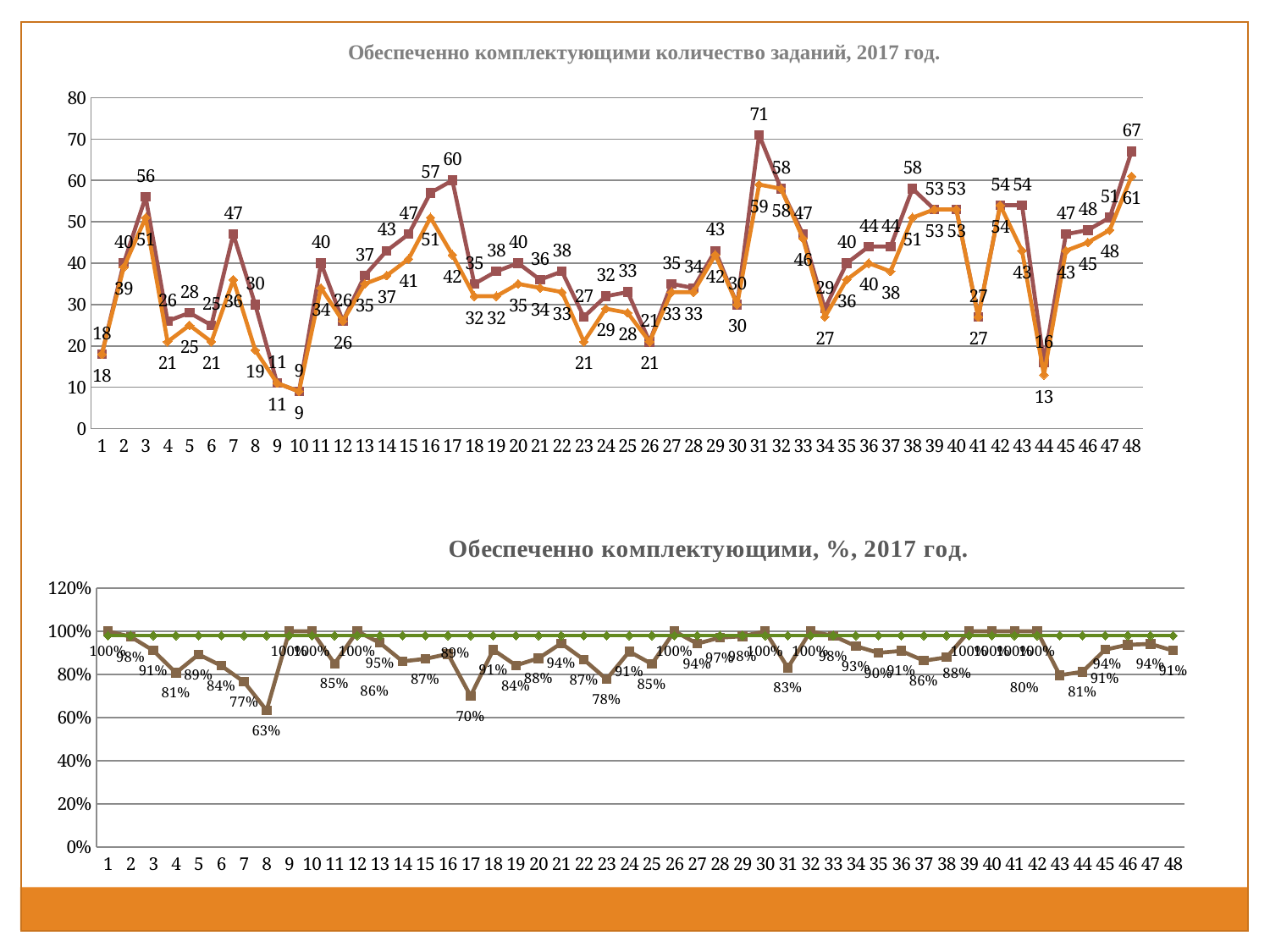
What kind of chart is the top chart titled "Обеспеченно комплектующими количество заданий, 2017 год."? line chart In the top chart, at which x-axis point does the brown (square-marker) line reach its highest value? 31 What is the title of the bottom chart? Обеспеченно комплектующими, %, 2017 год. In the bottom chart titled "Обеспеченно комплектующими, %, 2017 год.", what is the lowest percentage shown on the brown line? 63% In the top chart, what is the value of the orange (diamond-marker) line at point 48? 61 In the top chart, what is the value of the brown (square-marker) line at point 48? 67 In the top chart, at which x-axis point do both lines reach their lowest value? 10 In the top chart, which point has the larger value on the brown line: point 31 or point 32? 31 How many x-axis points are plotted in the top chart? 48 In the top chart, what is the difference between the brown line and the orange line at point 48? 6 In the top chart, what is the highest value shown on the brown (square-marker) line? 71 In the bottom chart, what is the percentage value at point 17? 70%